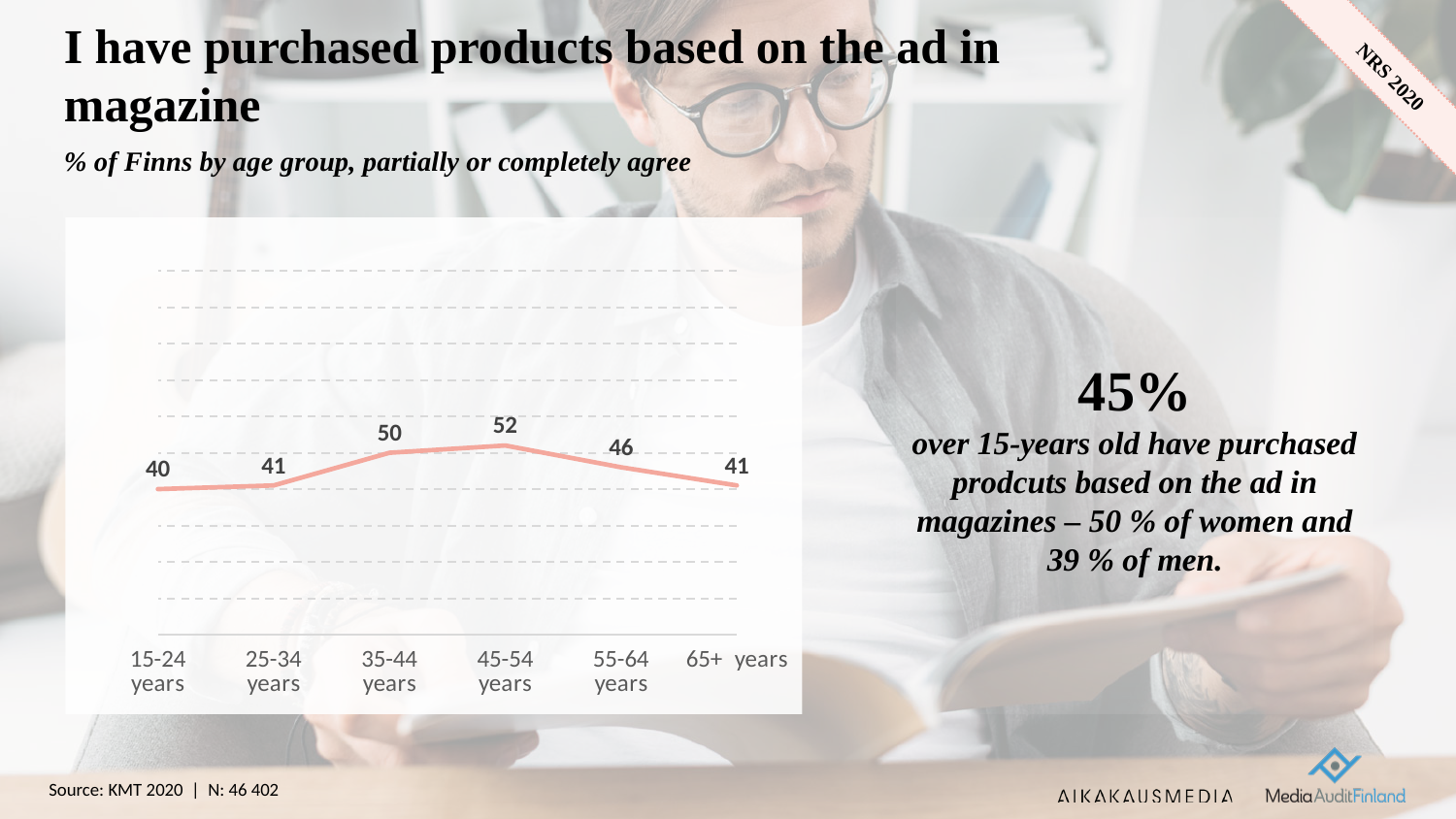
What is the difference between the values for 55-64 years and 65+ years? 5 What is the value for the 15-24 years age group? 40 Which age group has the lowest value? 15-24 years What is the title of the chart on the slide? I have purchased products based on the ad in magazine How many age groups are plotted on the chart? 6 What is the value for the 45-54 years age group? 52 What is the difference between the values for 45-54 years and 15-24 years? 12 What kind of chart is shown on the slide? Line chart What is the value for the 55-64 years age group? 46 Which age group has the highest value? 45-54 years Do the values rise or fall from the 45-54 years group to the 65+ years group? Fall Which is larger, the value for 35-44 years or the value for 65+ years? 35-44 years